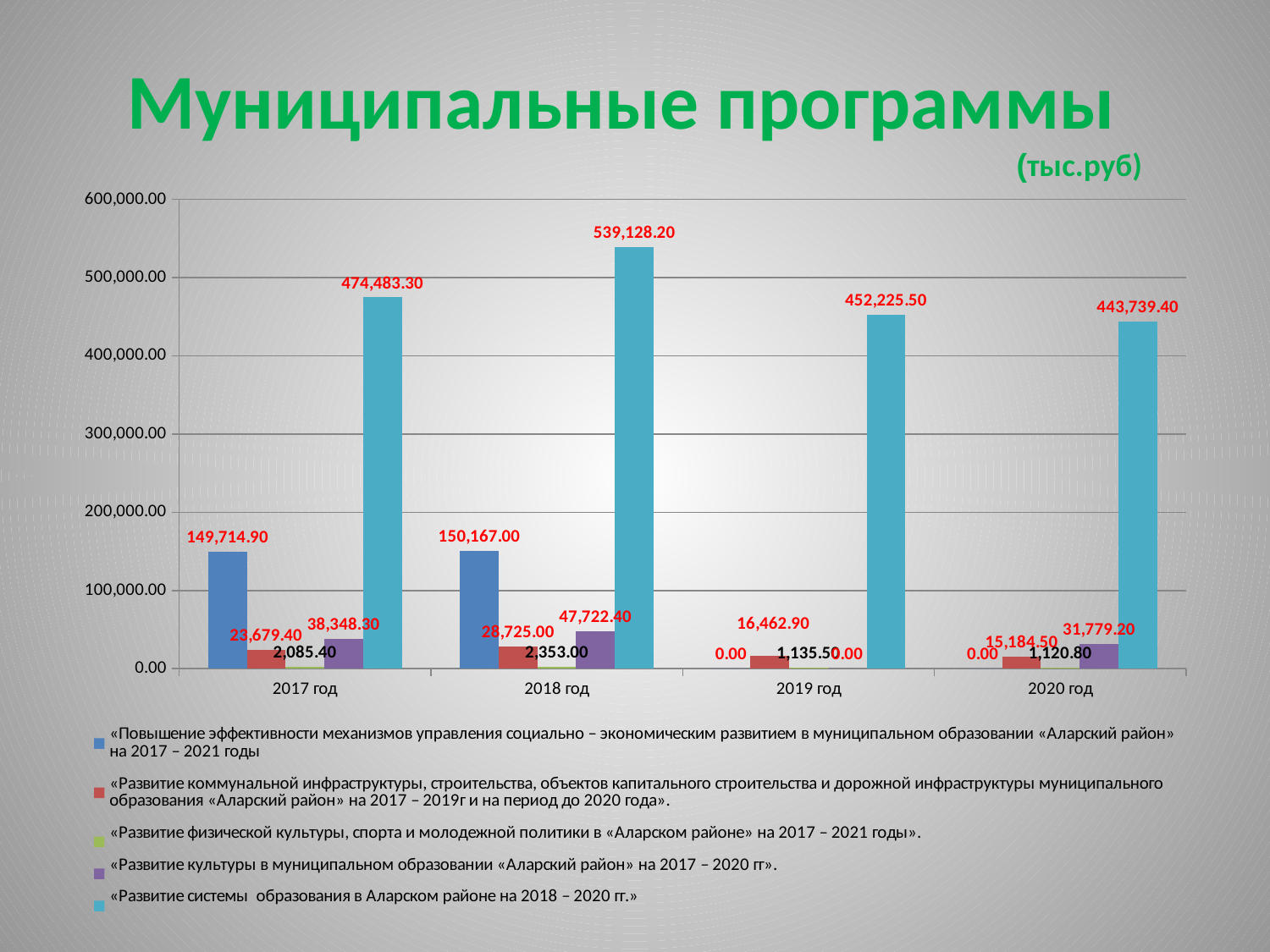
In which year is the education programme («Развитие системы образования») value highest? 2018 год What is the difference between the education programme values in 2018 год and 2017 год? 64,644.90 What is the value for the education programme («Развитие системы образования») in 2018 год? 539,128.20 What is the value for the communal infrastructure programme («Развитие коммунальной инфраструктуры») in 2019 год? 16,462.90 How many series does the legend list? 5 How many year categories are shown on the x axis? 4 Which is larger: the culture programme («Развитие культуры») value in 2017 год or in 2018 год? 2018 год Is the value for the education programme in 2019 год greater or less than 500,000.00? less What is the value for the culture programme («Развитие культуры») in 2020 год? 31,779.20 What type of chart is shown on the slide? bar chart What unit is stated under the chart title? тыс.руб In which year is the education programme («Развитие системы образования») value lowest? 2020 год